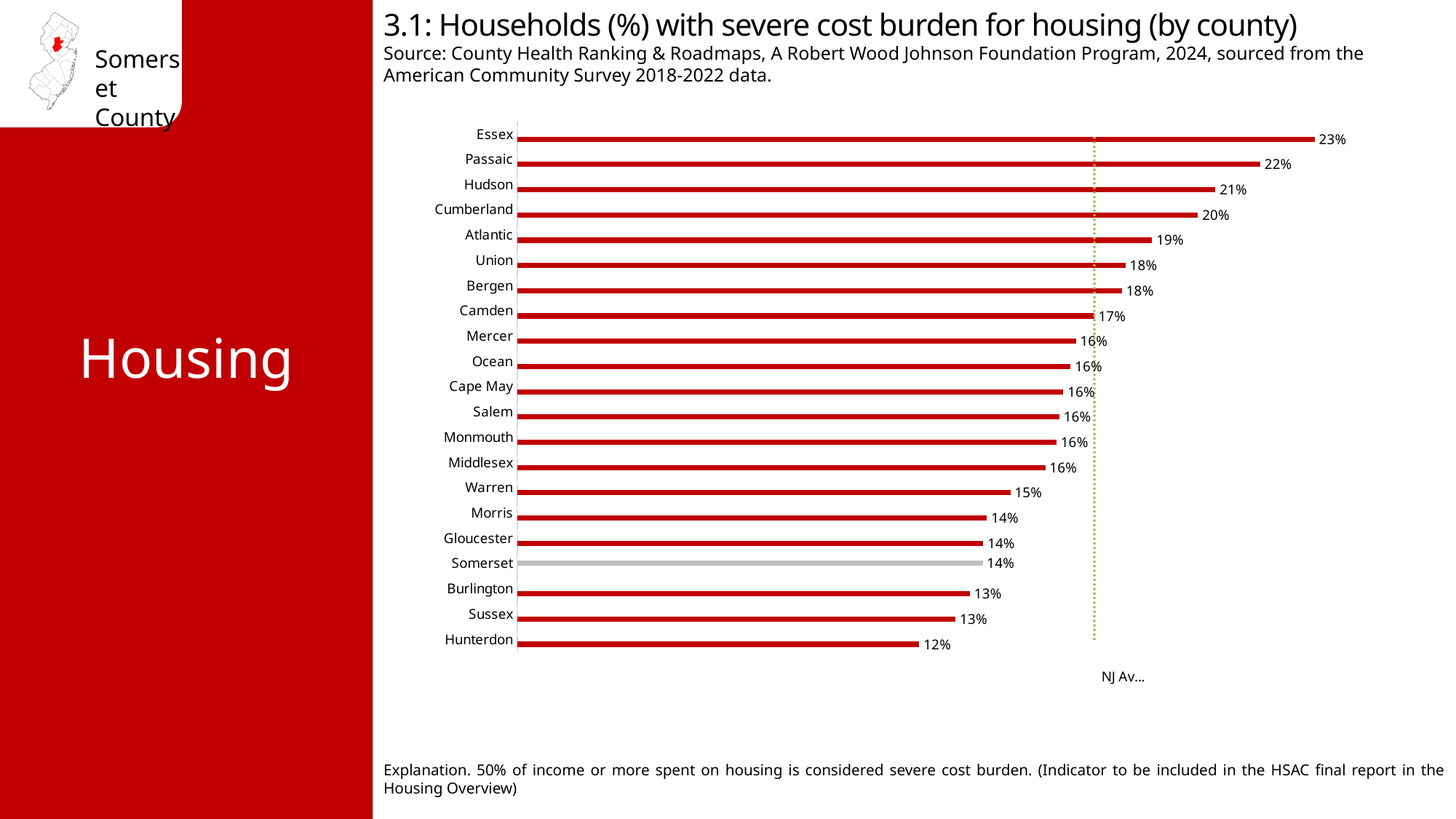
What is the difference in percentage points between Essex and Somerset? 9 percentage points What is the value shown for Somerset County? 14% Which county's bar is drawn in grey instead of red? Somerset What is the value shown for Cumberland County? 20% How many counties are shown in the chart? 21 Which county has the highest percentage of households with severe housing cost burden? Essex Which county has the lowest percentage of households with severe housing cost burden? Hunterdon What kind of chart is shown on the slide? Bar chart What is the value shown for Hunterdon County? 12% What percentage of households in Essex County have a severe cost burden for housing? 23% Do the values rise or fall going from the top bar to the bottom bar? Fall Which has a higher value, Hudson or Atlantic? Hudson